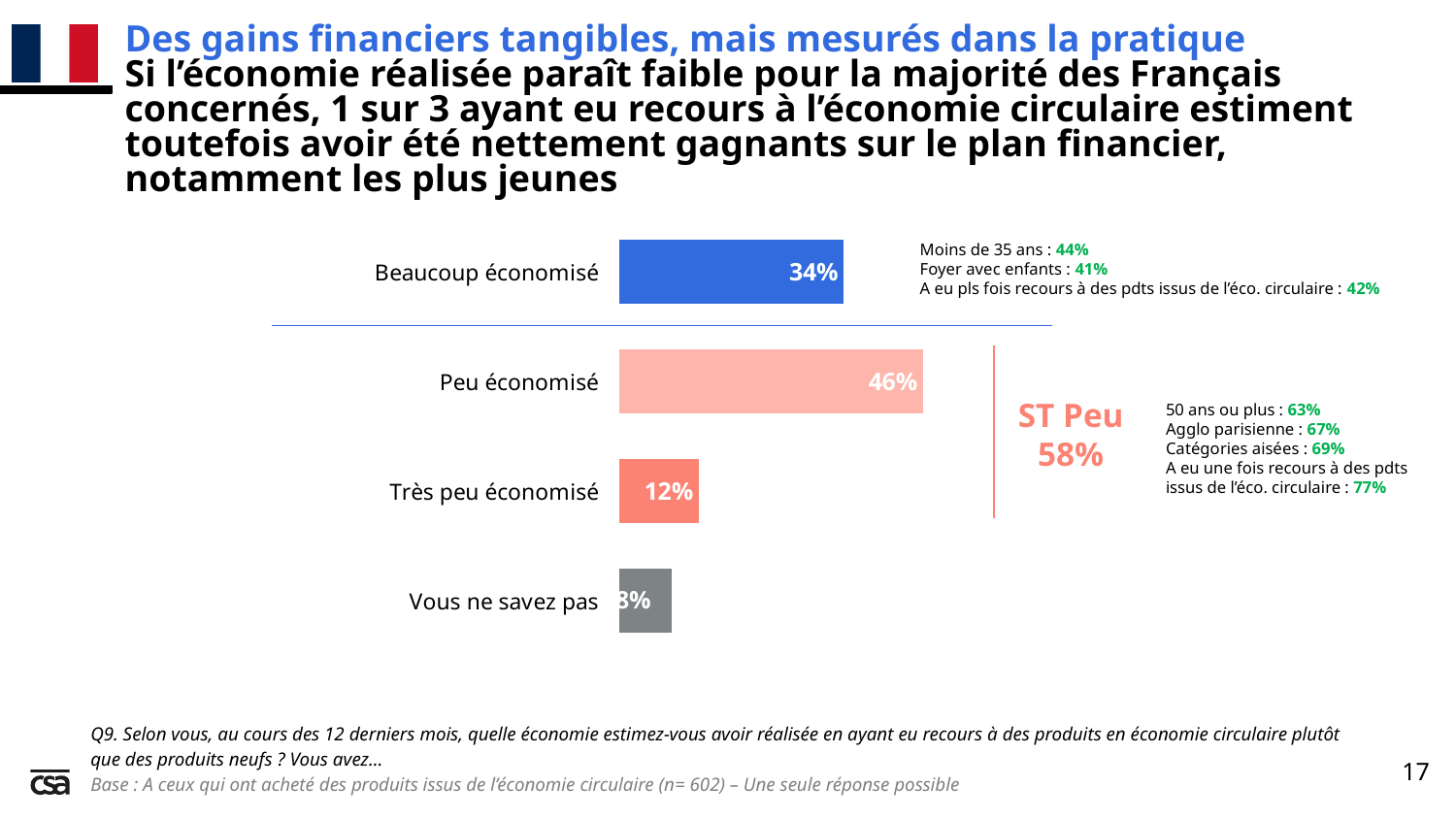
What kind of chart is shown on the slide? Bar chart What is the value for "Très peu économisé"? 12% Which is larger, "Beaucoup économisé" or "Très peu économisé"? Beaucoup économisé Which category has the lowest value? Vous ne savez pas What is the difference between "Peu économisé" and "Beaucoup économisé"? 12 percentage points What is the combined value shown for "ST Peu" (Peu économisé plus Très peu économisé)? 58% What is the value for "Peu économisé"? 46% Which category has the highest value? Peu économisé What is the value for "Vous ne savez pas"? 8% What is the value for "Beaucoup économisé"? 34% How many categories are shown in the bar chart? 4 What colour is the bar for "Beaucoup économisé"? Blue